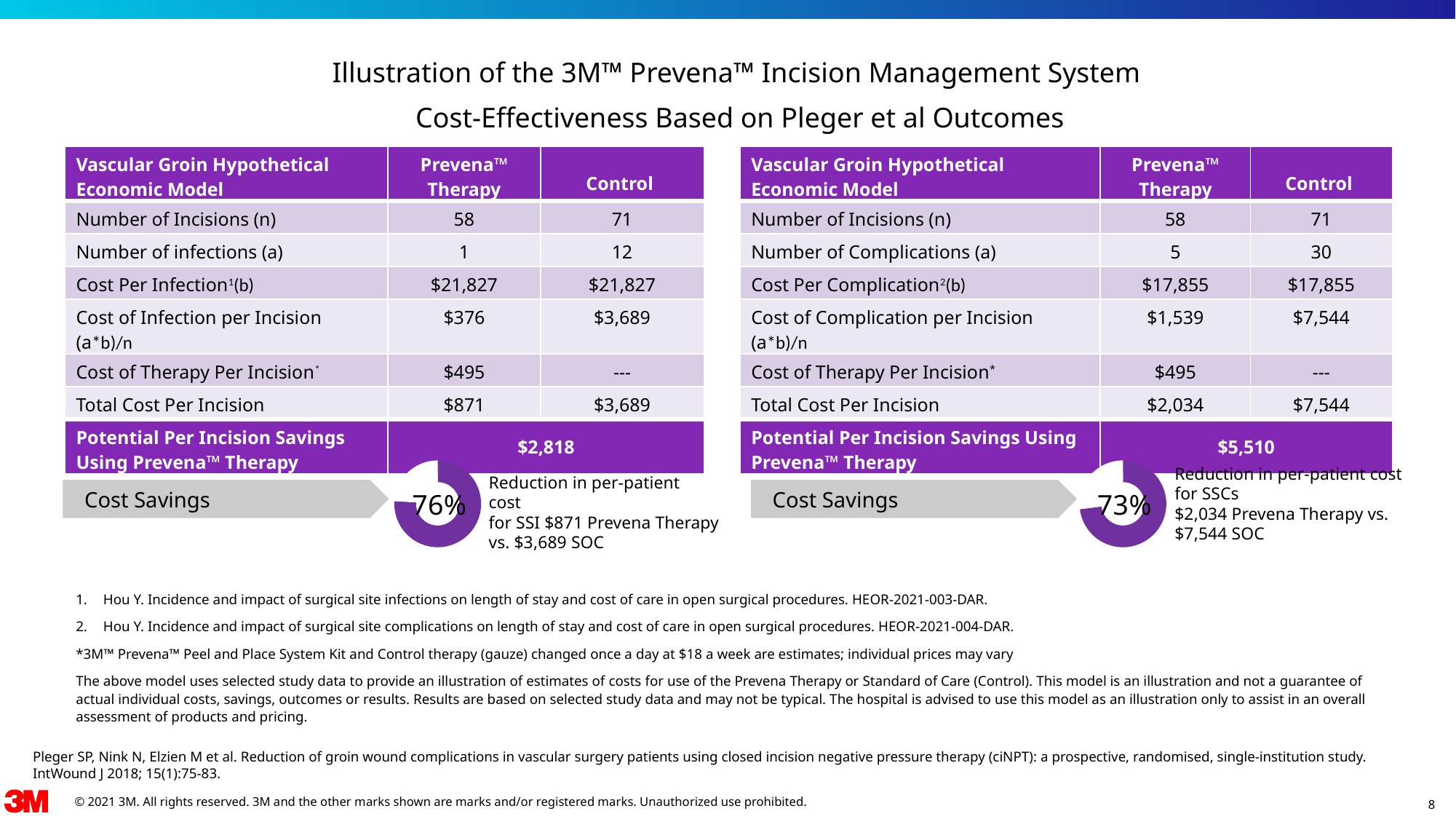
What percentage is shown in the left 'Cost Savings' donut chart? 76% How many donut charts are shown on the slide? 2 What kind of chart is the left 'Cost Savings' chart on the slide? Donut (pie) chart Which donut chart shows the larger percentage, the left one (SSI) or the right one (SSCs)? The left one (SSI), 76% What share of the left donut chart is filled by the highlighted (purple) segment? 76% What percentage is shown in the right 'Cost Savings' donut chart? 73% What colour is the filled segment of the donut charts on the slide? Purple Is the value shown in the right 'Cost Savings' donut chart greater or less than 50%? greater What does the left donut chart's 76% represent, according to the text beside it? Reduction in per-patient cost for SSI ($871 Prevena Therapy vs. $3,689 SOC) What is the difference in percentage points between the left donut chart (76%) and the right donut chart (73%)? 3 percentage points